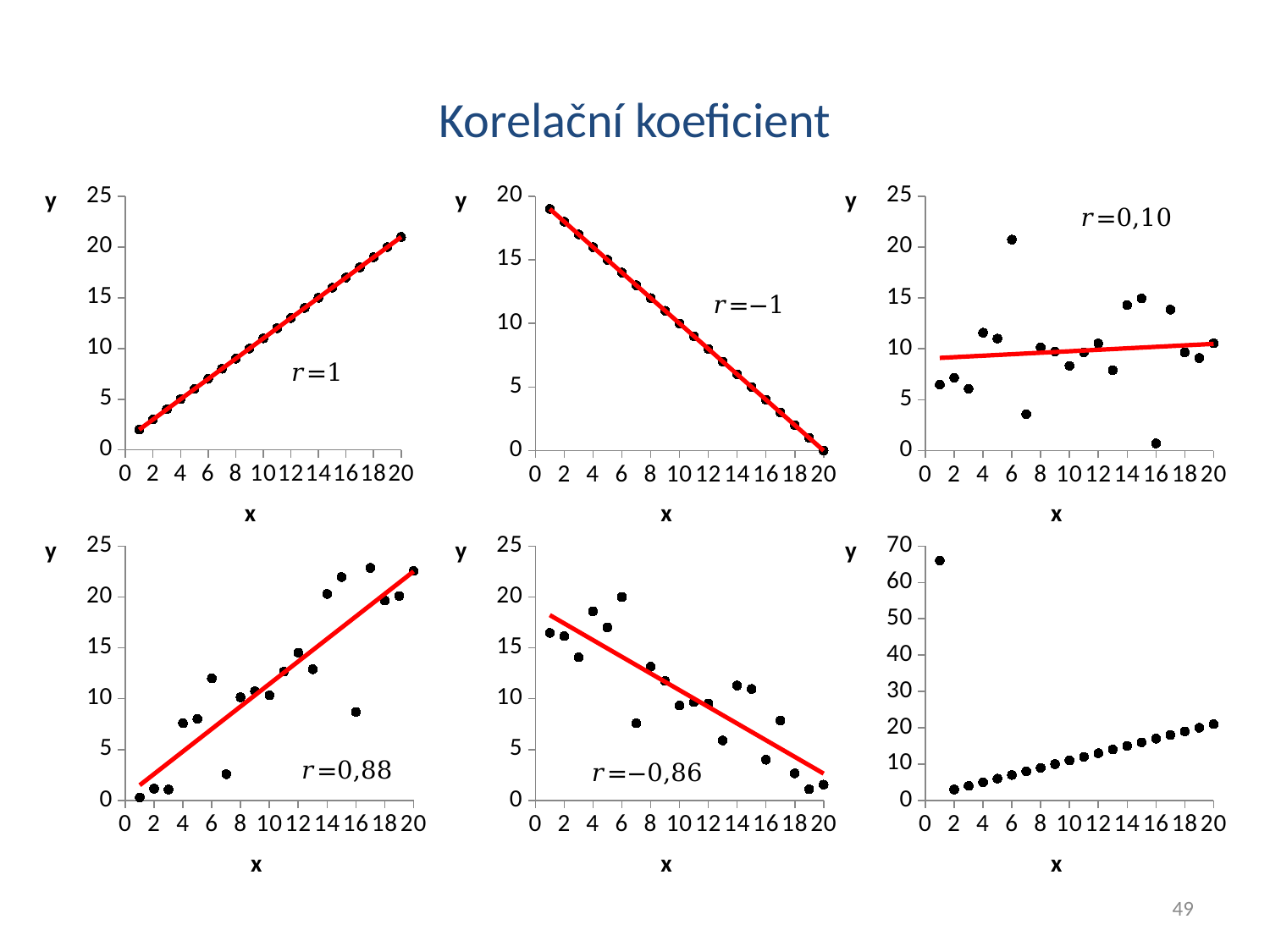
In the top-right chart (r=0,10), at which x value is the y value highest? 6 In the top-left chart, what correlation coefficient r is printed on the chart? r=1 In the top-middle chart (r=−1), is the y value at x=2 greater or less than 15? greater In the bottom-middle chart (r=−0,86), do the y values generally rise or fall as x increases? fall In the bottom-middle chart, what correlation coefficient r is printed on the chart? r=−0,86 How many data points are plotted in the top-left chart (r=1)? 20 What kind of chart is the top-left chart (r=1)? scatter chart In the top-middle chart (r=−1), do the y values rise or fall as x increases? fall In the top-right chart (r=0,10), is the y value at x=6 greater or less than 15? greater In the top-right chart (r=0,10), at which x value is the y value lowest? 16 In the bottom-left chart (r=0,88), do the y values generally rise or fall as x increases? rise In the bottom-right chart, is the y value at x=1 greater or less than 60? greater